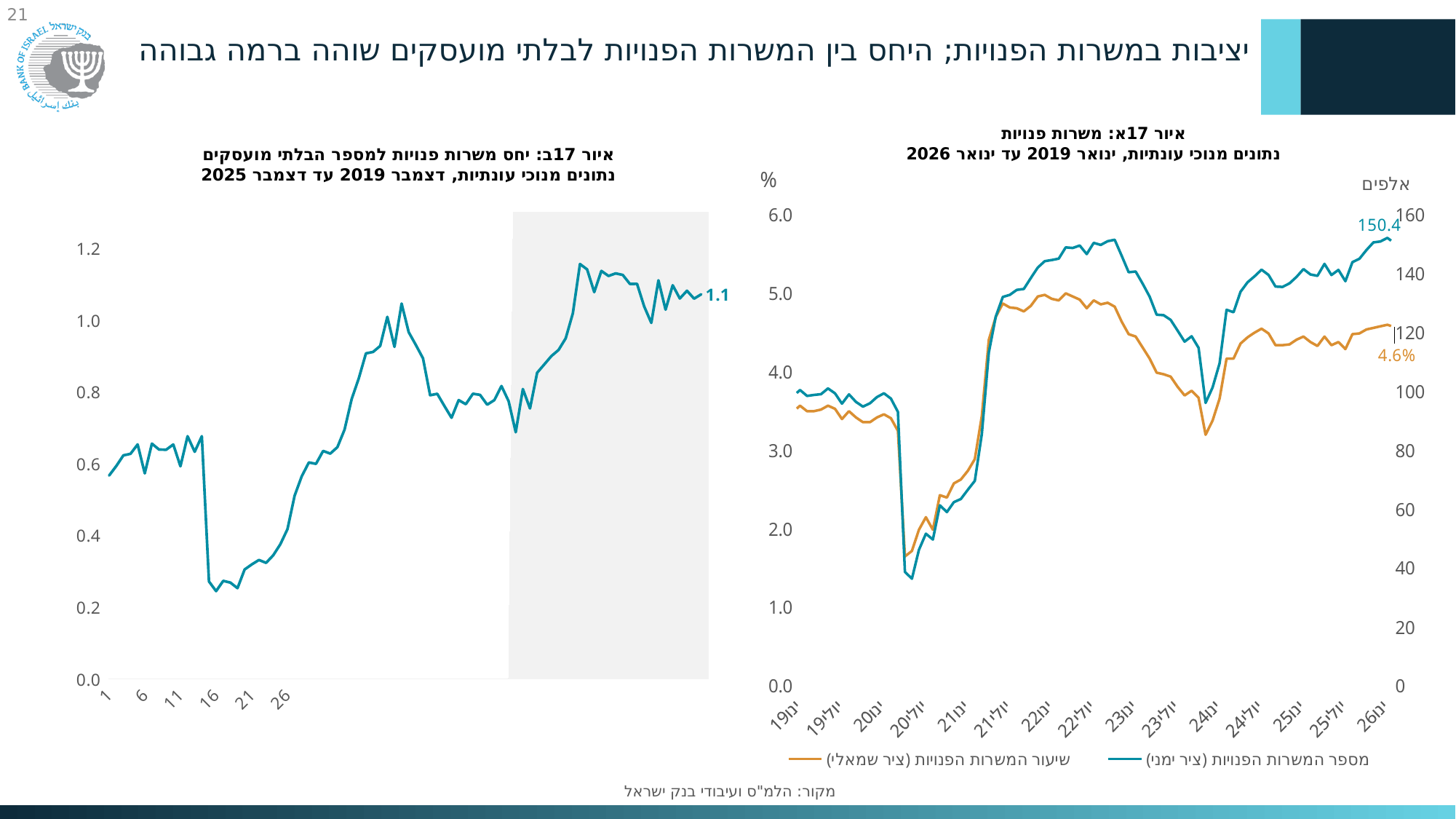
How many series does the legend of the right-hand chart (איור 17א) list? 2 What kind of chart is the left-hand chart (איור 17ב)? line chart In the left-hand chart (איור 17ב), is the value at x = 1 greater or less than 0.8? less In the left-hand chart (איור 17ב), is the value at x = 16 greater or less than 0.4? less In the right-hand chart (איור 17א), what is the labelled final value of the number of vacancies series (מספר המשרות הפנויות)? 150.4 In the right-hand chart (איור 17א), does the number of vacancies series rise or fall between ינו24 and ינו26? rises In the right-hand chart (איור 17א), is the number of vacancies at ינו19 greater or less than 120 (thousands)? less In the right-hand chart (איור 17א), what is the labelled final value of the vacancy rate series (שיעור המשרות הפנויות)? 4.6% What kind of chart is the right-hand chart (איור 17א: משרות פנויות)? line chart In the left-hand chart (איור 17ב), what is the labelled value at the end of the line? 1.1 In the right-hand chart (איור 17א), what unit is shown at the top of the right-hand axis? אלפים